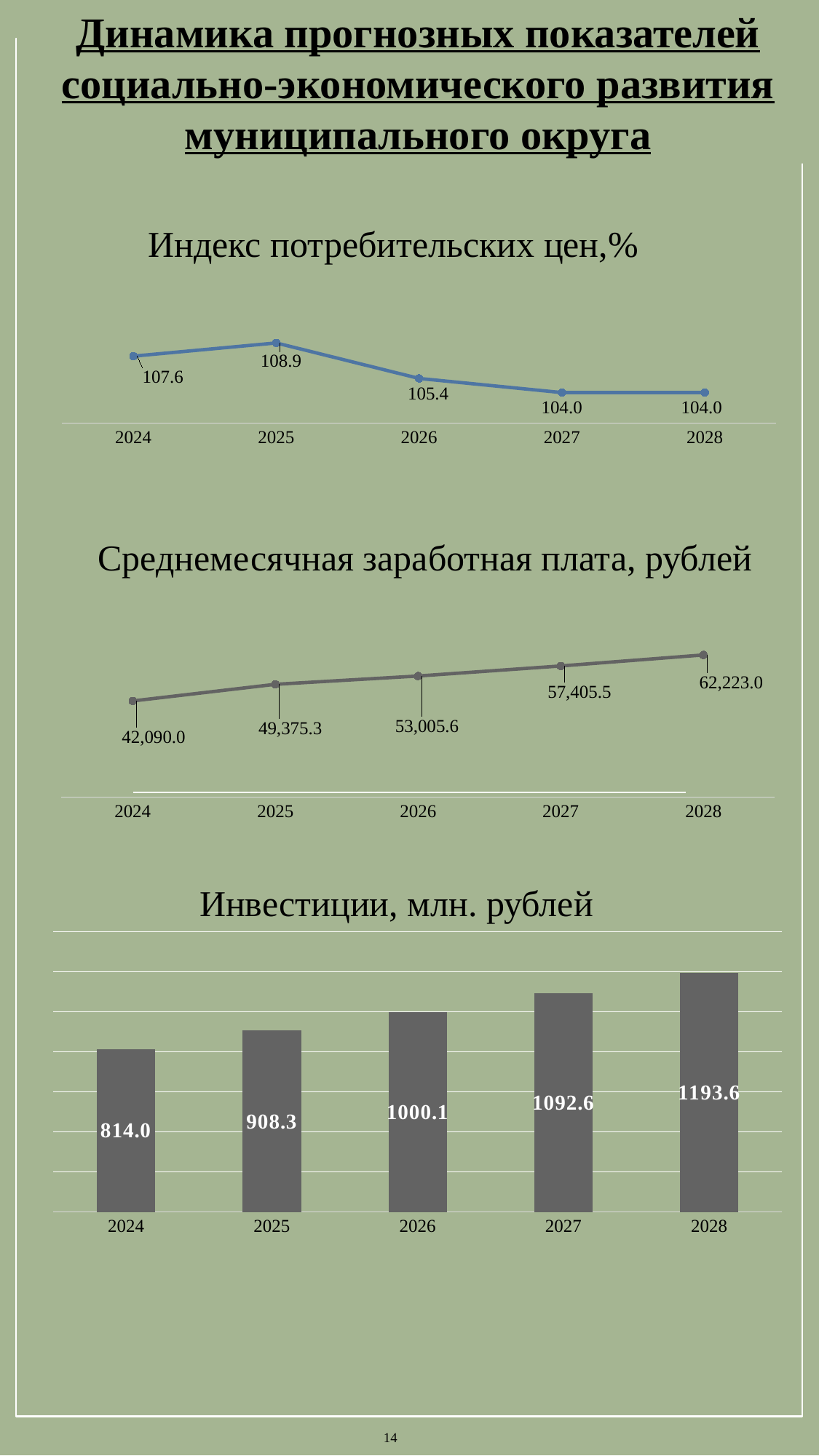
In the chart 'Инвестиции, млн. рублей', what is the difference between the 2028 and 2024 values? 379.6 In the chart 'Среднемесячная заработная плата, рублей', what is the value for 2026? 53,005.6 In the chart 'Среднемесячная заработная плата, рублей', which year has the lowest value? 2024 In the chart 'Среднемесячная заработная плата, рублей', what is the difference between the 2028 and 2024 values? 20,133.0 In the chart 'Среднемесячная заработная плата, рублей', do the values rise or fall from 2024 to 2028? rise In the chart 'Инвестиции, млн. рублей', what is the value for 2027? 1092.6 In the chart 'Индекс потребительских цен,%', how many data points are plotted? 5 In the chart 'Инвестиции, млн. рублей', which is larger, the value for 2026 or the value for 2025? 2026 In the chart 'Индекс потребительских цен,%', what is the difference between the 2025 and 2024 values? 1.3 In the chart 'Индекс потребительских цен,%', what is the value for 2025? 108.9 In the chart 'Индекс потребительских цен,%', which year has the highest value? 2025 What type of chart is 'Инвестиции, млн. рублей'? bar chart